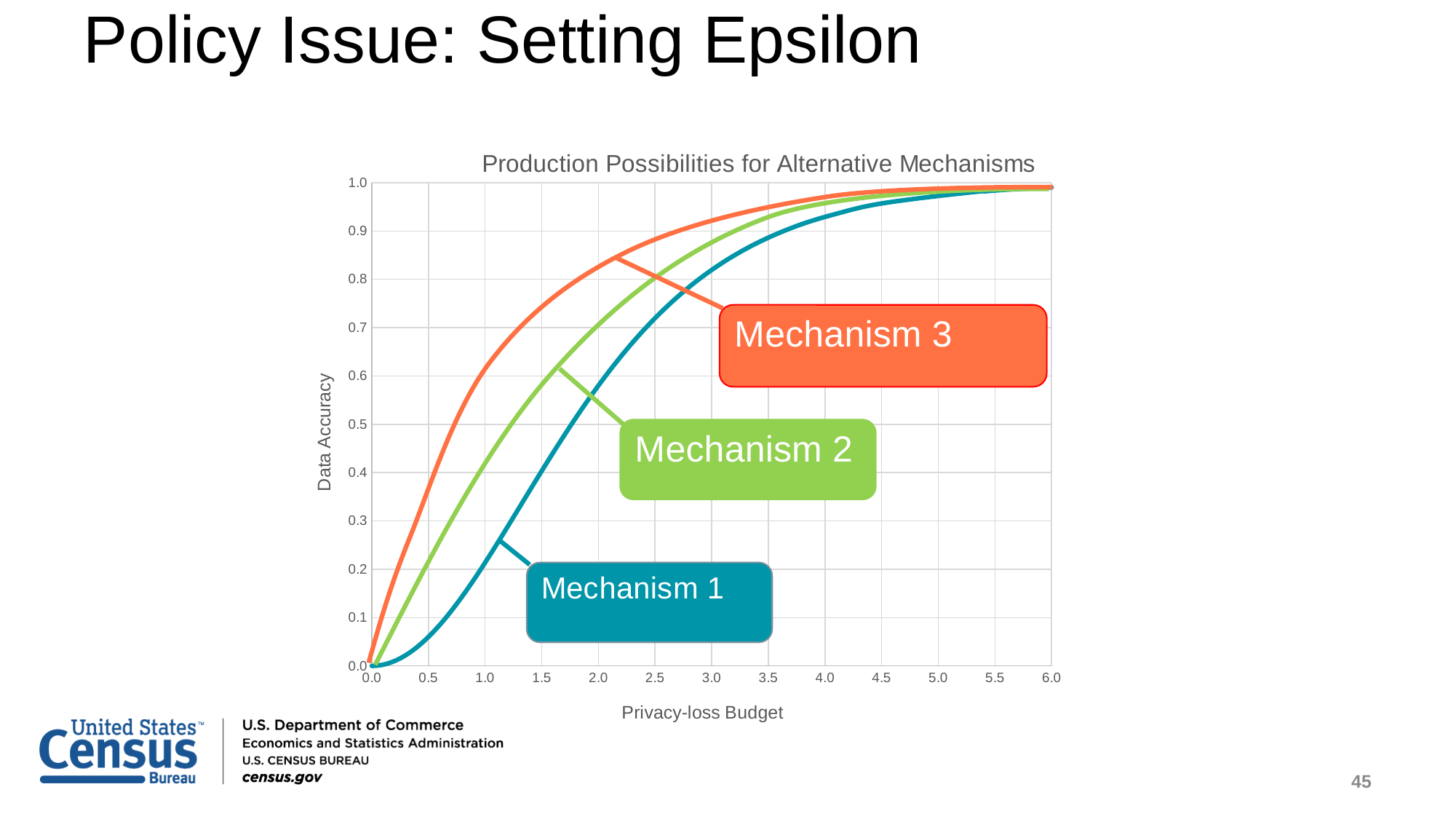
Does data accuracy rise or fall as the privacy-loss budget increases for each mechanism? rise Is the data accuracy for Mechanism 1 at a privacy-loss budget of 1.0 greater or less than 0.3? less Is the data accuracy for Mechanism 2 at a privacy-loss budget of 2.0 greater or less than 0.6? greater Which mechanism has the highest data accuracy at a privacy-loss budget of 1.0? Mechanism 3 Is the data accuracy for Mechanism 3 at a privacy-loss budget of 1.0 greater or less than 0.5? greater What is the title of the chart? Production Possibilities for Alternative Mechanisms How many mechanisms (series) are plotted on the chart? 3 What is the label of the x axis? Privacy-loss Budget What kind of chart is shown on the slide? line chart Which mechanism has the lowest data accuracy at a privacy-loss budget of 1.0? Mechanism 1 At a privacy-loss budget of 2.0, which has higher data accuracy, Mechanism 2 or Mechanism 1? Mechanism 2